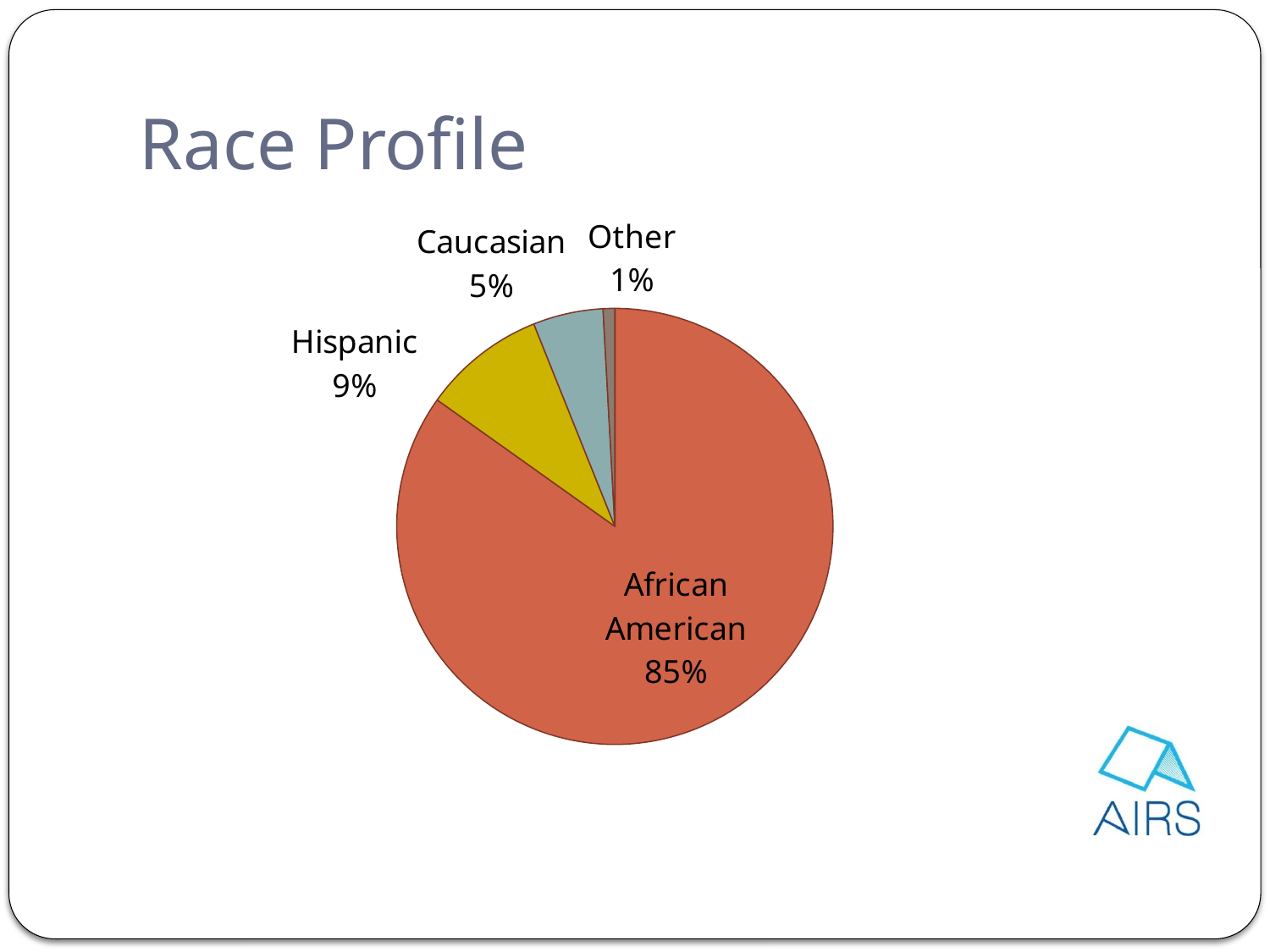
Which is larger, the Caucasian slice or the Other slice? Caucasian How many categories are shown in the pie chart? 4 What is the value for Hispanic? 9% What is the value for Caucasian? 5% Which category has the largest slice? African American What is the value for Other? 1% What is the title of the slide containing the chart? Race Profile Which category has the smallest slice? Other What is the difference between the Hispanic and Caucasian shares? 4% What kind of chart is shown on the slide? pie chart What share of the pie does African American represent? 85% What is the difference between the African American and Hispanic shares? 76%